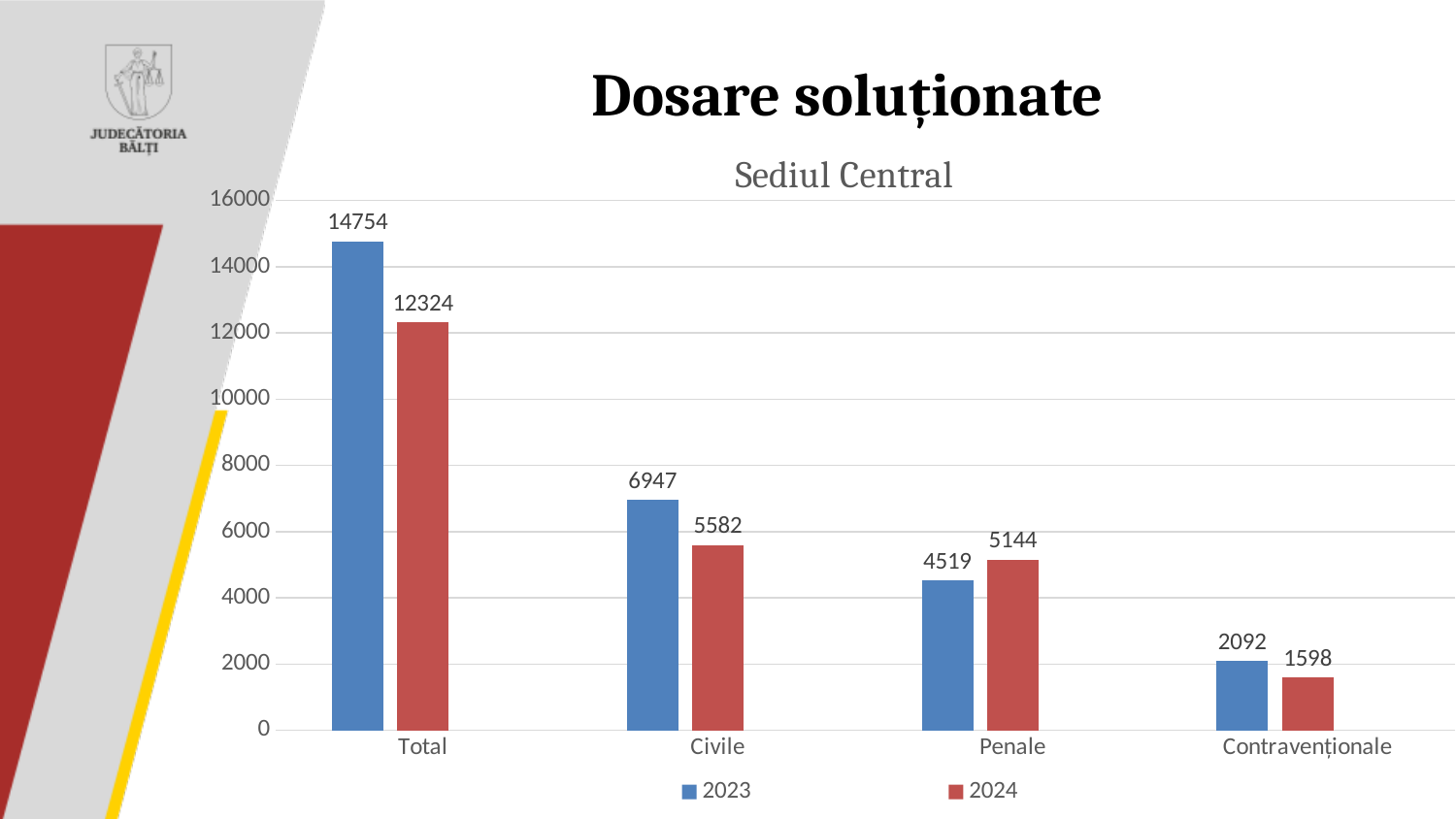
Which category has the lowest value in 2024? Contravenționale What is the difference between the 2023 and 2024 values for Total? 2430 What is the value for Civile in 2023? 6947 What is the difference between the 2024 and 2023 values for Penale? 625 Excluding the Total category, which category has the highest value in 2023? Civile What is the value for Penale in 2024? 5144 How many series does the legend list? 2 Which is larger for Penale, the 2023 value or the 2024 value? 2024 How many categories are shown on the x axis? 4 What kind of chart is shown on the slide? Bar chart What is the Total value for 2024? 12324 What is the value for Contravenționale in 2023? 2092